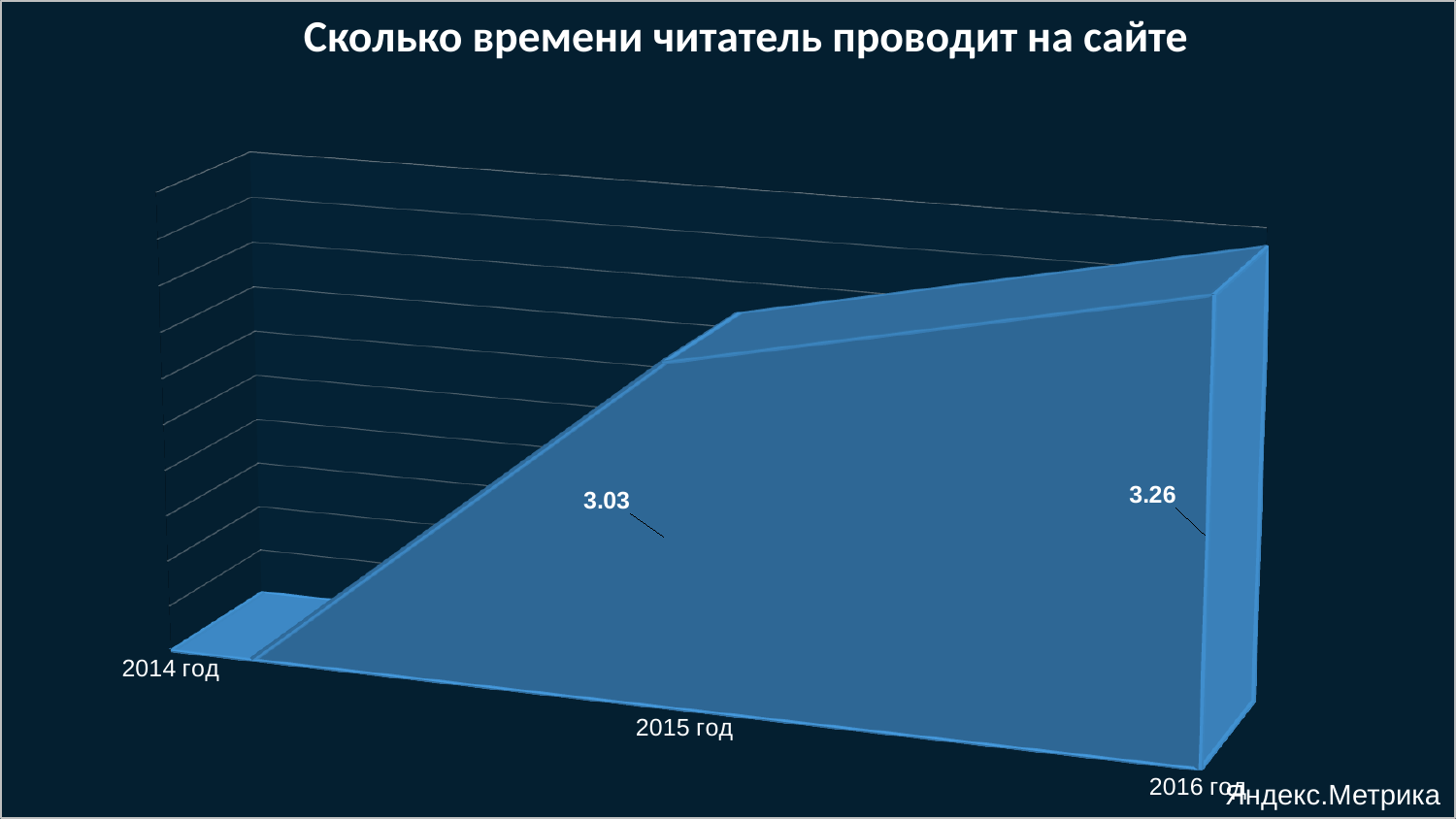
Which is larger, the value for 2015 год or the value for 2016 год? 2016 год Which is larger, the value for 2014 год or the value for 2015 год? 2015 год Which year has the lowest value? 2014 год What is the title of the chart? Сколько времени читатель проводит на сайте What data source is named on the slide? Яндекс.Метрика What is the difference between the values for 2016 год and 2015 год? 0.23 What is the value for 2016 год? 3.26 What kind of chart is this? Area chart Which year has the highest value? 2016 год Do the values rise or fall from 2014 год to 2016 год? Rise How many years are shown on the chart? 3 What is the value for 2015 год? 3.03